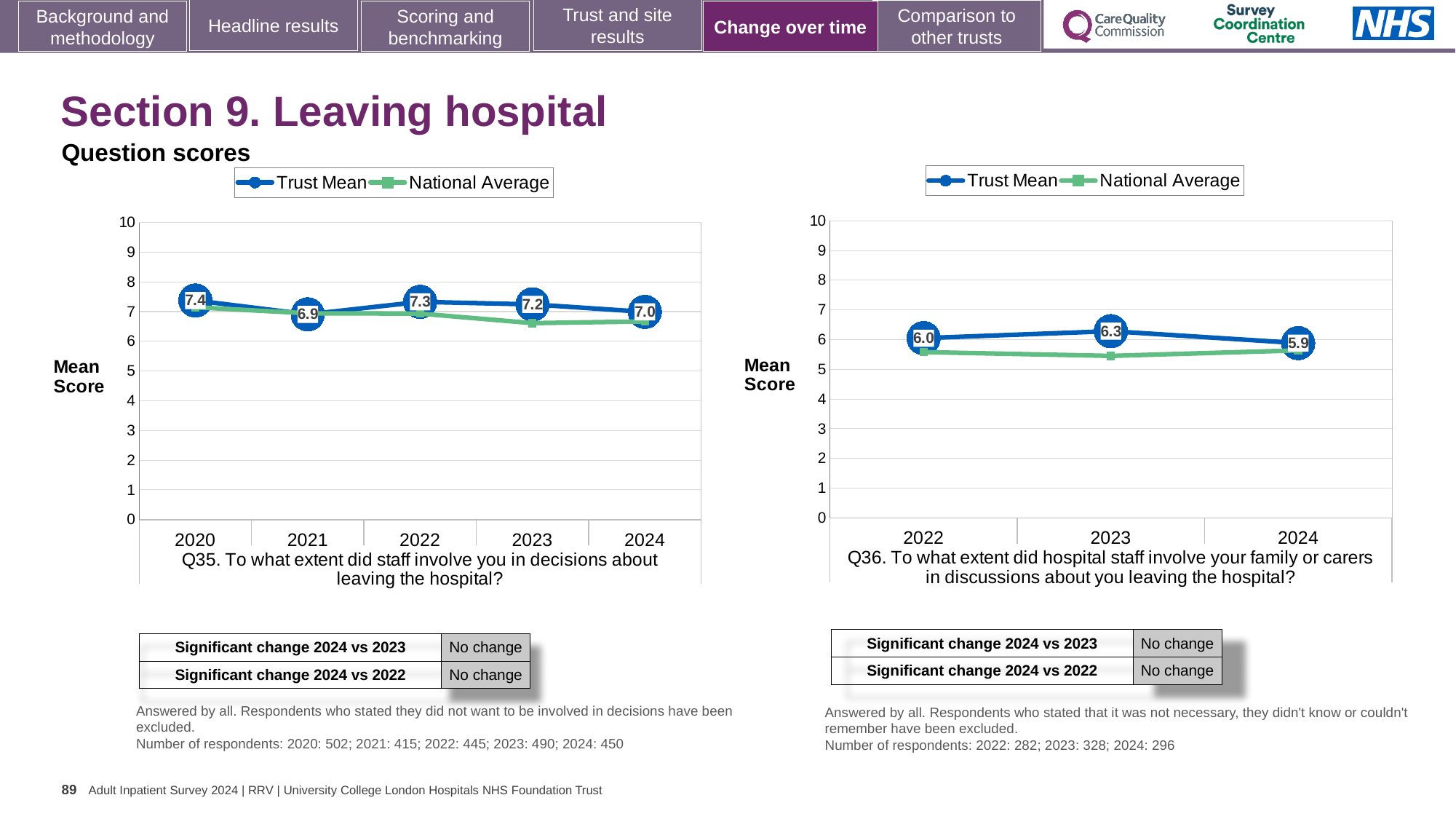
In the Q35 chart (left), how many years are plotted on the x axis? 5 In the Q35 chart (left), what is the Trust Mean score for 2020? 7.4 In the Q36 chart (right), is the Trust Mean score for 2022 larger or smaller than the score for 2023? smaller In the Q36 chart (right), what is the Trust Mean score for 2023? 6.3 In the Q35 chart (left), which year has the highest Trust Mean score? 2020 In the Q36 chart (right), is the National Average value for 2023 greater or less than 6? less How many series does the legend of the Q36 chart (right) list? 2 In the Q36 chart (right), which year has the lowest Trust Mean score? 2024 In the Q35 chart (left), what is the difference between the Trust Mean scores for 2020 and 2021? 0.5 What type of chart is the Q35 chart (left)? Line chart In the Q35 chart (left), what is the Trust Mean score for 2024? 7.0 In the Q35 chart (left), which year has the lowest Trust Mean score? 2021